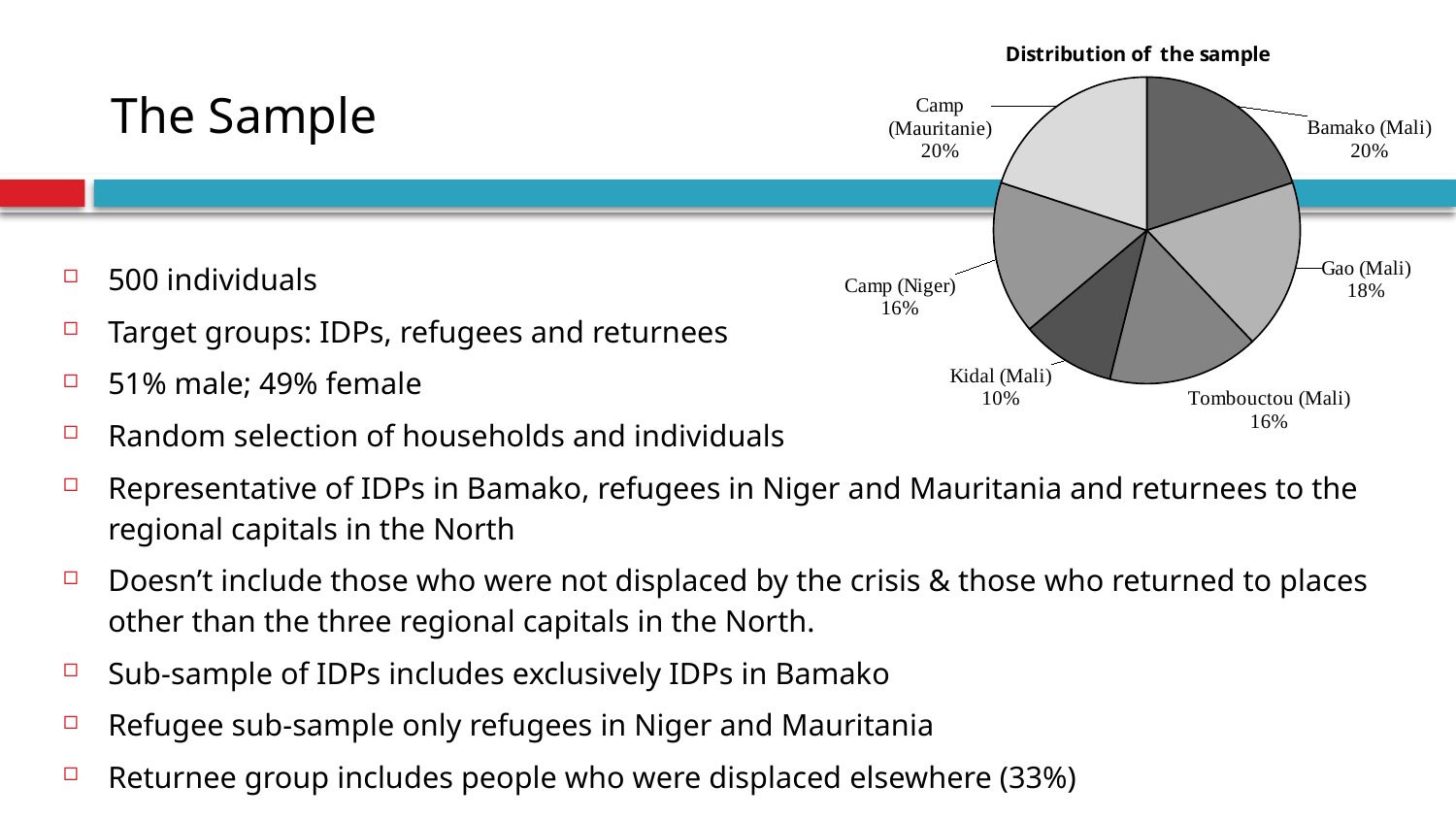
What share of the sample is from Gao (Mali)? 18% What is the combined share of Tombouctou (Mali) and Camp (Niger)? 32% Which has a larger share of the sample, Gao (Mali) or Tombouctou (Mali)? Gao (Mali) Which has a larger share of the sample, Camp (Niger) or Camp (Mauritanie)? Camp (Mauritanie) What share of the sample is from Camp (Mauritanie)? 20% What share of the sample is from Camp (Niger)? 16% What is the title of the chart? Distribution of the sample Which category has the smallest share of the sample? Kidal (Mali) What share of the sample is from Kidal (Mali)? 10% What kind of chart is shown on the slide? Pie chart How many categories are shown in the pie chart? 6 What is the difference in percentage points between the Bamako (Mali) share and the Kidal (Mali) share? 10